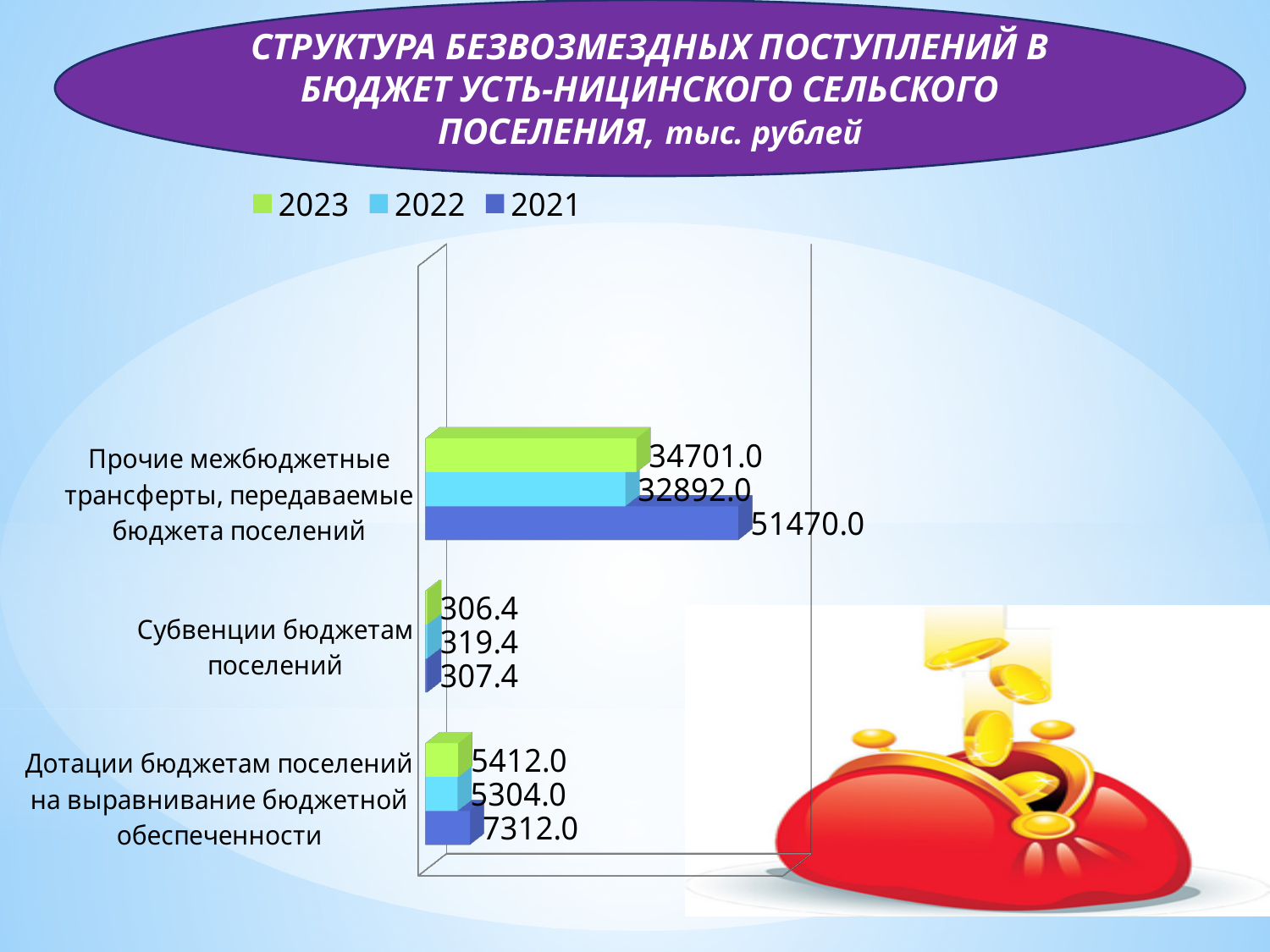
What is the difference between the 2021 and 2022 values for "Дотации бюджетам поселений на выравнивание бюджетной обеспеченности"? 2008.0 What kind of chart is shown on the slide? Bar chart What is the value for 2022 for "Дотации бюджетам поселений на выравнивание бюджетной обеспеченности"? 5304.0 What is the difference between the 2021 and 2023 values for "Прочие межбюджетные трансферты, передаваемые бюджета поселений"? 16769.0 What is the value for 2023 for "Прочие межбюджетные трансферты, передаваемые бюджета поселений"? 34701.0 Which category has the highest value for 2021? Прочие межбюджетные трансферты, передаваемые бюджета поселений How many categories are shown on the chart? 3 What is the value for 2021 for "Прочие межбюджетные трансферты, передаваемые бюджета поселений"? 51470.0 What is the value for 2023 for "Субвенции бюджетам поселений"? 306.4 How many series does the legend list? 3 For "Субвенции бюджетам поселений", which year has the larger value, 2022 or 2021? 2022 Which category has the lowest value for 2023? Субвенции бюджетам поселений